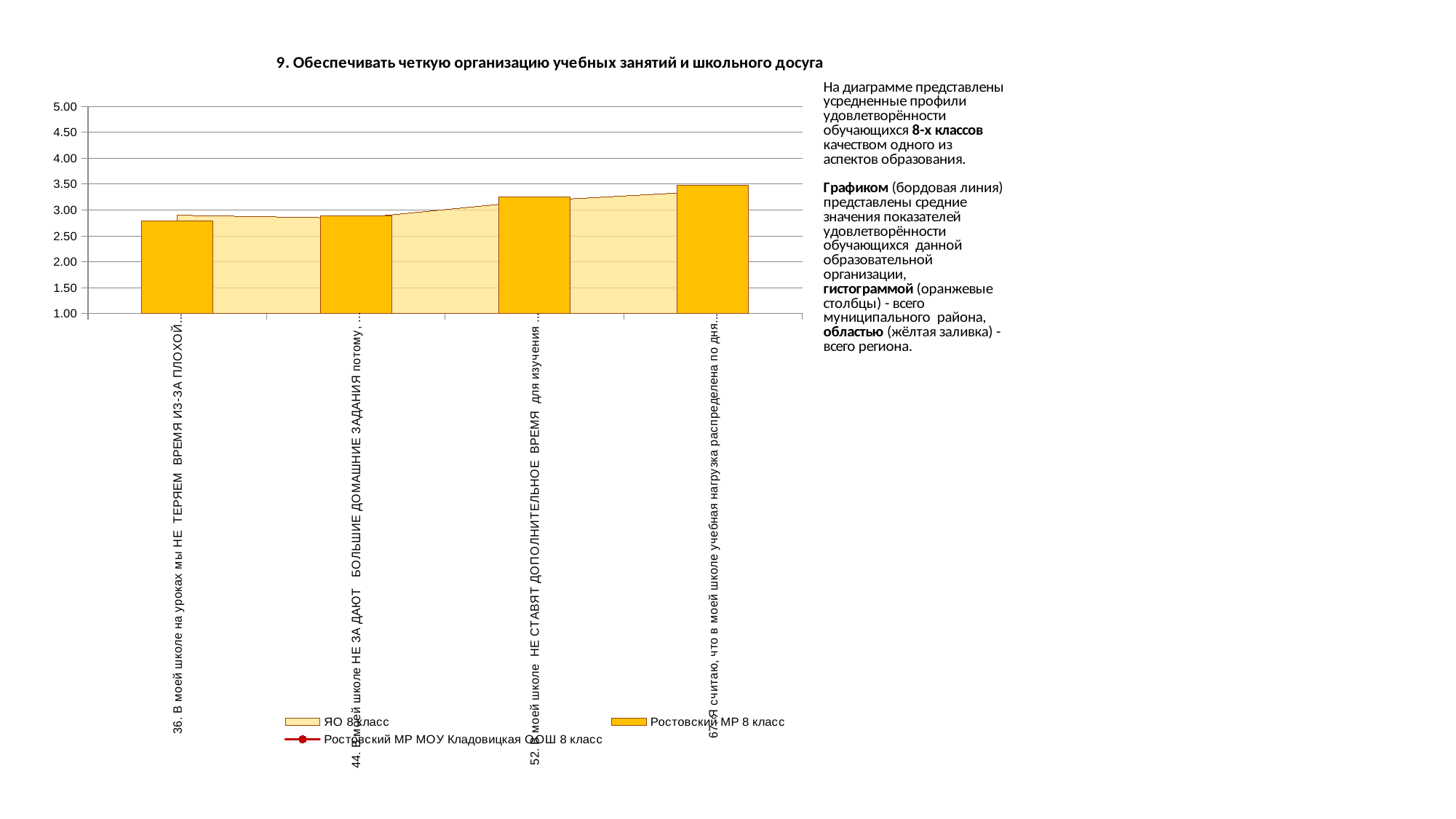
How many categories (survey items) are shown along the x axis of the chart? 4 Is the orange bar (Ростовский МР 8 класс) for item 67 greater or less than 3.00? greater What is the title of the chart on the slide? 9. Обеспечивать четкую организацию учебных занятий и школьного досуга Which category has the lowest orange bar (Ростовский МР 8 класс)? 36 How many series does the chart legend list? 3 Which is larger for Ростовский МР 8 класс: the bar for item 67 or the bar for item 36? item 67 Which category has the highest orange bar (Ростовский МР 8 класс)? 67 Is the orange bar (Ростовский МР 8 класс) for item 36 greater or less than 3.00? less What colour are the bars for the series Ростовский МР 8 класс? orange Do the orange bars (Ростовский МР 8 класс) generally rise or fall from left to right along the x axis? rise Is the orange bar (Ростовский МР 8 класс) for item 52 greater or less than 3.00? greater What is the highest value shown on the chart's vertical axis? 5.00